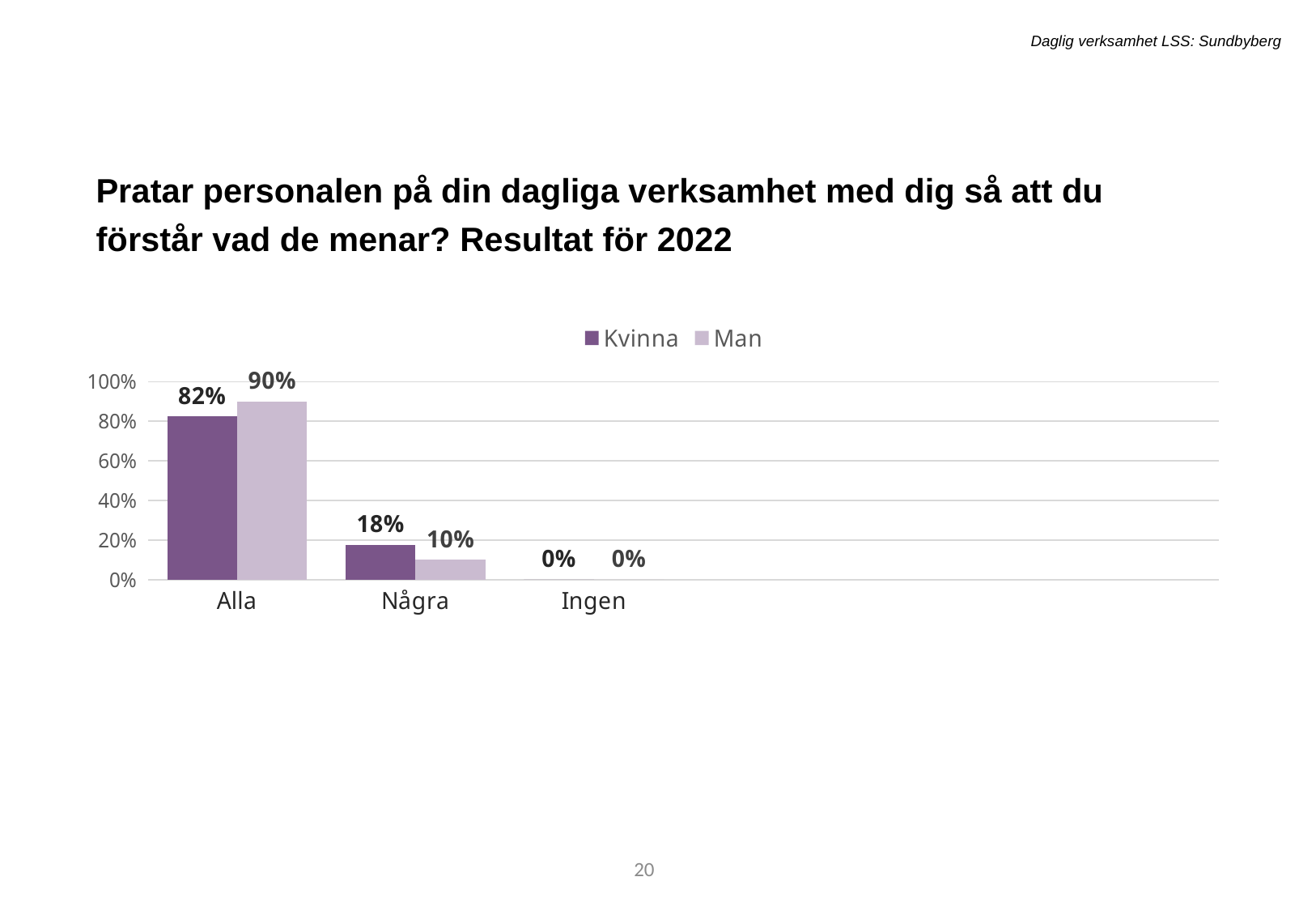
What kind of chart is shown on the slide? Bar chart Which category has the highest value for Man? Alla How many categories are shown on the x axis? 3 In the Några category, which series has the larger value, Kvinna or Man? Kvinna How many series does the legend list? 2 What is the value for Kvinna in the Ingen category? 0% What is the value for Kvinna in the Några category? 18% What is the value for Man in the Några category? 10% Which category has the lowest value for Kvinna? Ingen What is the value for Kvinna in the Alla category? 82% What is the value for Man in the Alla category? 90% What is the difference between the Man and Kvinna values in the Alla category? 8%